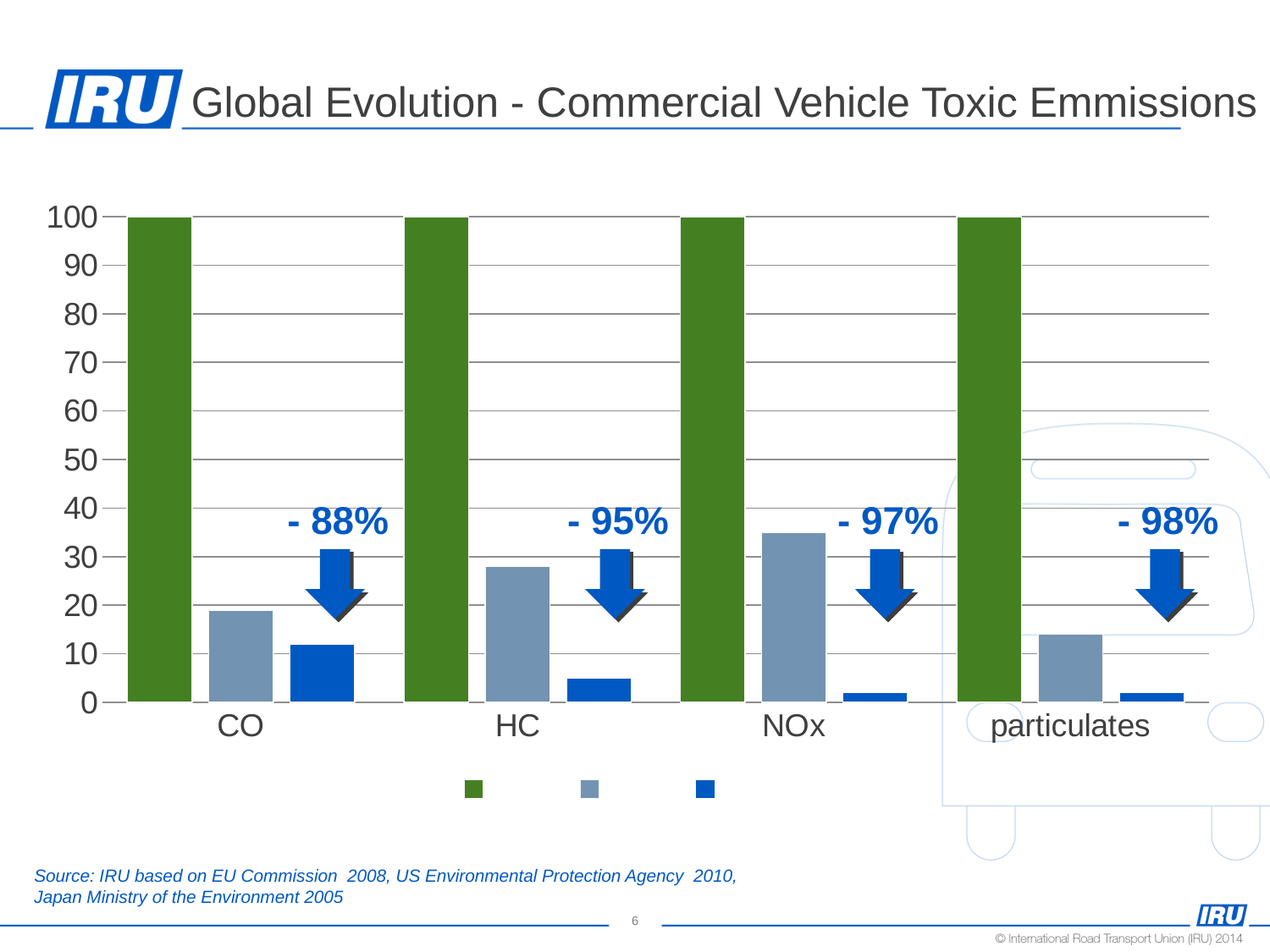
Which is larger, the grey bar for HC or the grey bar for CO? HC What is the title of the slide containing the chart? Global Evolution - Commercial Vehicle Toxic Emmissions Is the blue bar for HC greater or less than 10? less How many series does the legend list? 3 Which category has the highest grey bar? NOx Is the grey bar for NOx greater or less than 30? greater How many categories are shown on the x axis of the chart? 4 What percentage reduction is annotated above the NOx group? - 97% What kind of chart is shown on the slide? bar chart What is the value of the green bar for CO? 100 Which category has the lowest grey bar? particulates What percentage reduction is annotated above the particulates group? - 98%